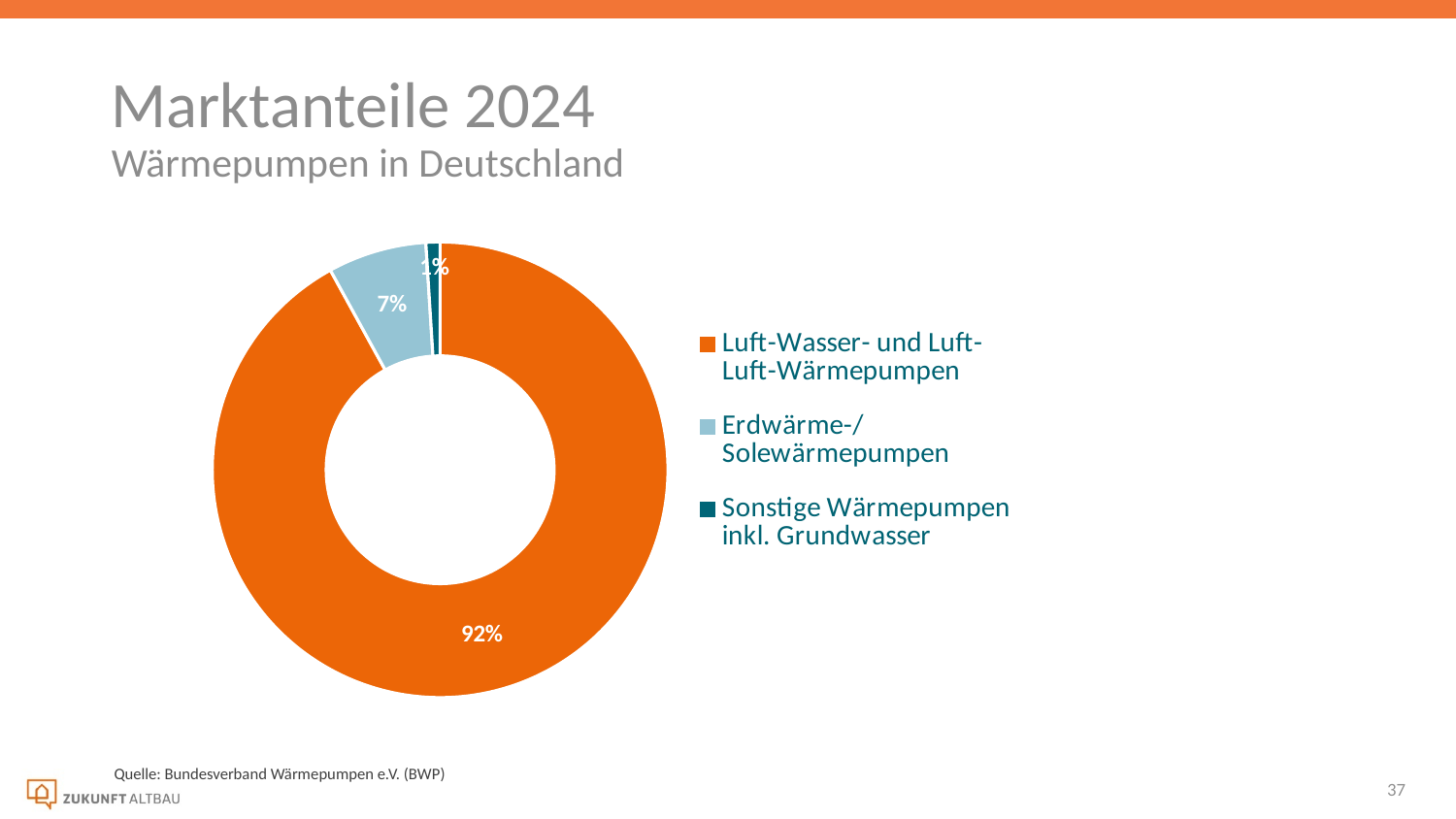
What colour is the slice for Erdwärme-/Solewärmepumpen? Light blue What share of the market do Erdwärme-/Solewärmepumpen hold? 7% What share of the market do Luft-Wasser- und Luft-Luft-Wärmepumpen hold? 92% What kind of chart is shown on the slide? Doughnut (pie) chart Which category has the largest share of the chart? Luft-Wasser- und Luft-Luft-Wärmepumpen Which has a larger share: Erdwärme-/Solewärmepumpen or Sonstige Wärmepumpen inkl. Grundwasser? Erdwärme-/Solewärmepumpen What is the difference in percentage points between the share of Luft-Wasser- und Luft-Luft-Wärmepumpen and Erdwärme-/Solewärmepumpen? 85 percentage points Which category has the smallest share of the chart? Sonstige Wärmepumpen inkl. Grundwasser What is the title of the slide containing the chart? Marktanteile 2024 – Wärmepumpen in Deutschland What is the combined share of Erdwärme-/Solewärmepumpen and Sonstige Wärmepumpen inkl. Grundwasser? 8% How many categories does the chart show? 3 What share of the market do Sonstige Wärmepumpen inkl. Grundwasser hold? 1%